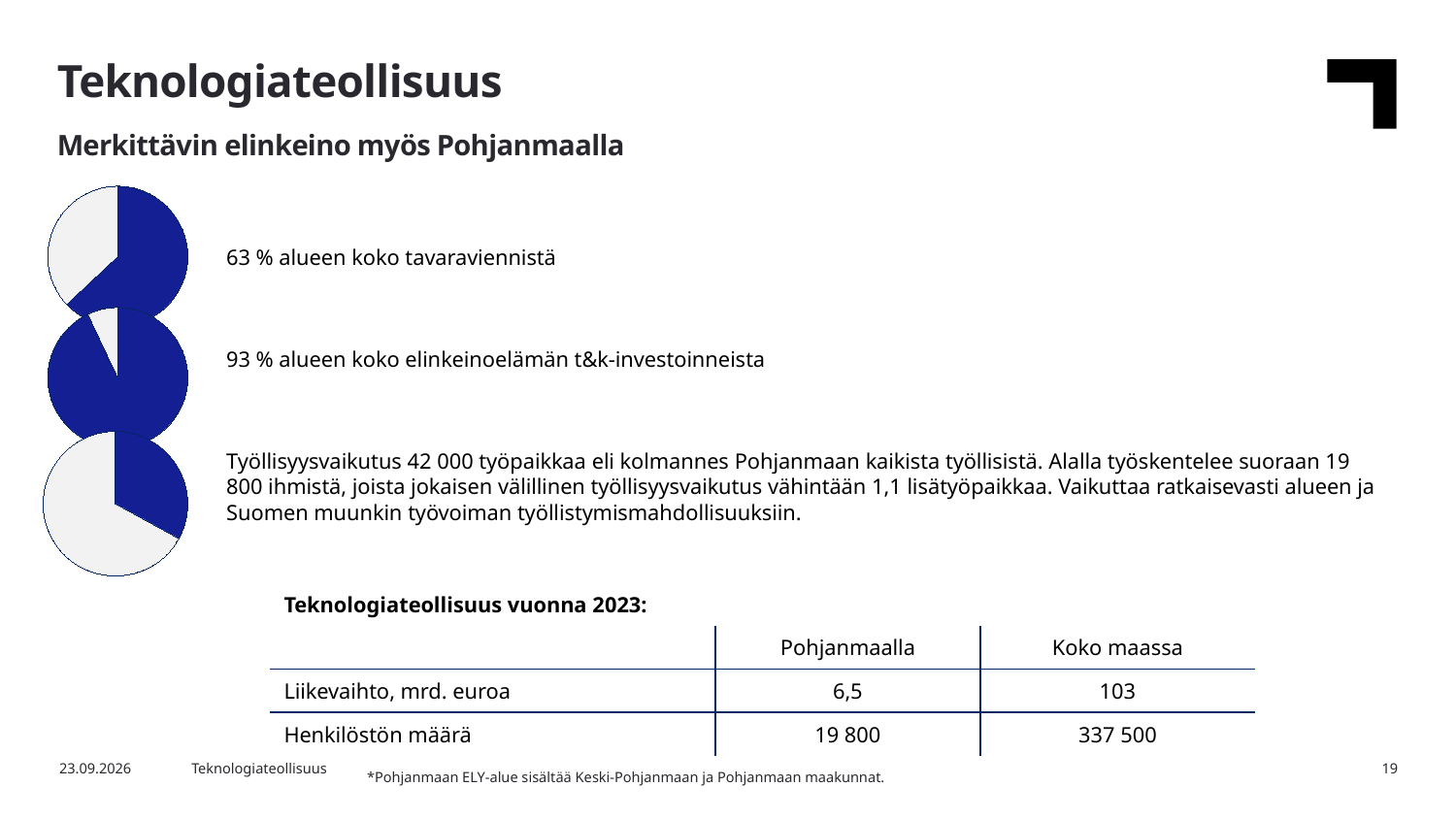
How many pie charts are on the slide? 3 Is the blue share in the bottom pie chart greater or less than 50 %? less Which of the three pie charts has the largest blue slice? The middle pie chart (93 %) Is the blue slice in the top pie chart larger or smaller than the blue slice in the middle pie chart? Smaller What kind of charts are shown on the left side of the slide? Pie charts In the middle pie chart, what share of the region's business R&D investments does the blue slice represent? 93 % Which of the three pie charts has the smallest blue slice? The bottom pie chart In the top pie chart, what share of the region's total goods exports does the blue slice represent? 63 % Is the blue share in the top pie chart greater or less than 50 %? greater How many slices does each pie chart on the slide have? 2 What is the difference in percentage points between the blue shares of the middle and top pie charts? 30 percentage points What colour is used for the highlighted slice in each pie chart? Dark blue